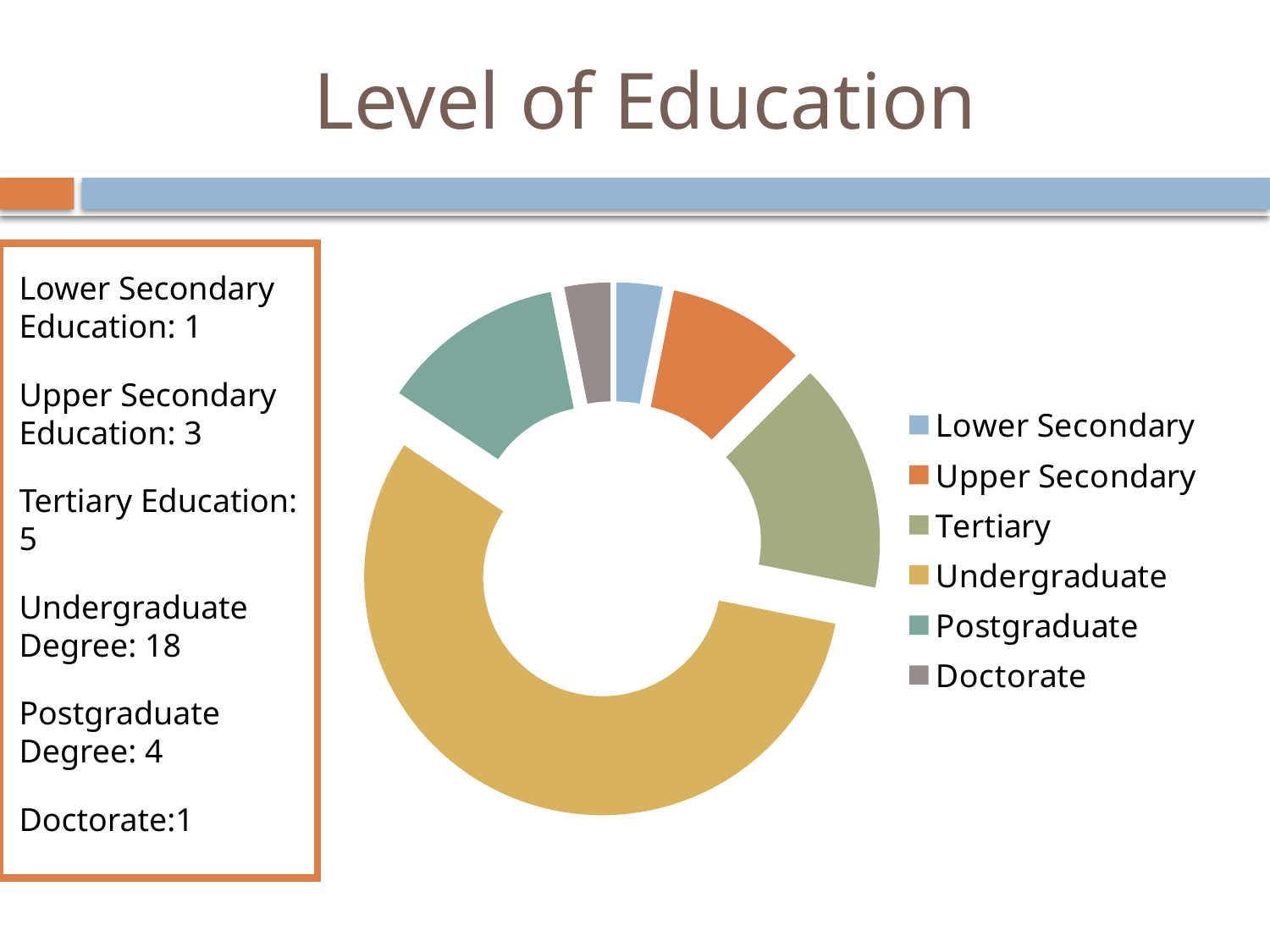
What is the value for Upper Secondary Education? 3 How many categories does the legend of the chart list? 6 Which is larger, the Postgraduate slice or the Doctorate slice? Postgraduate What is the difference between the Undergraduate value and the Tertiary value? 13 What is the value for Tertiary Education? 5 What is the value for Postgraduate Degree? 4 Which category has the largest slice in the chart? Undergraduate What is the total of all the values shown in the chart? 32 What kind of chart is shown on the slide? doughnut chart What colour is the Undergraduate slice in the chart? yellow Which is larger, the Upper Secondary slice or the Tertiary slice? Tertiary What is the value for Undergraduate Degree? 18